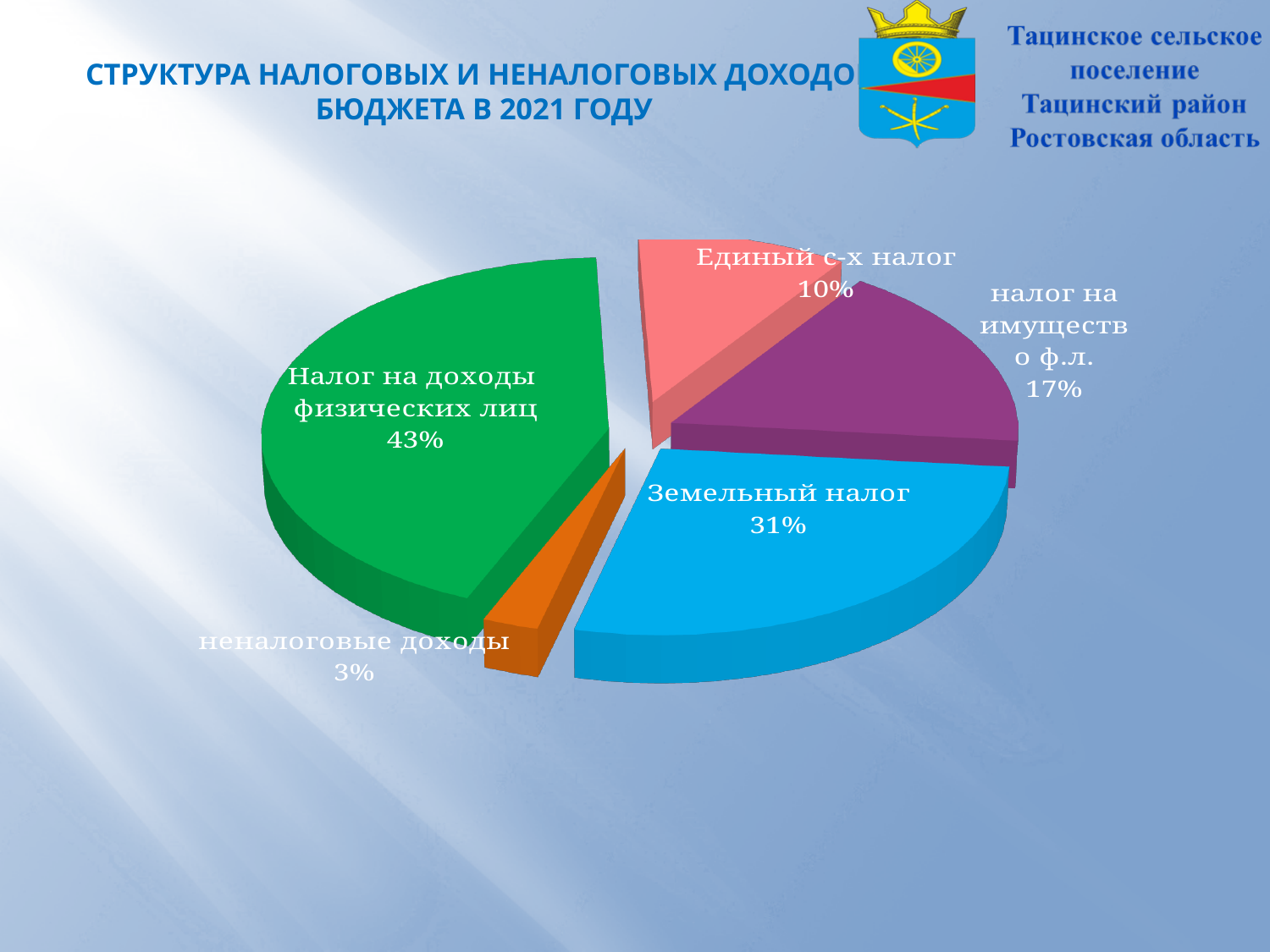
How many slices does the pie chart have? 5 What is the difference in percentage points between "Налог на доходы физических лиц" and "Земельный налог"? 12 What colour is the slice for "Земельный налог"? Blue Which category has the largest share of the pie? Налог на доходы физических лиц What is the value shown for "налог на имущество ф.л."? 17% What share of the pie does "Налог на доходы физических лиц" have? 43% What is the value shown for "неналоговые доходы"? 3% Which category has the smallest share of the pie? неналоговые доходы What is the value shown for "Единый с-х налог"? 10% What type of chart is shown on the slide? Pie chart Which is larger: "налог на имущество ф.л." or "Единый с-х налог"? налог на имущество ф.л. What share of the pie does "Земельный налог" have? 31%